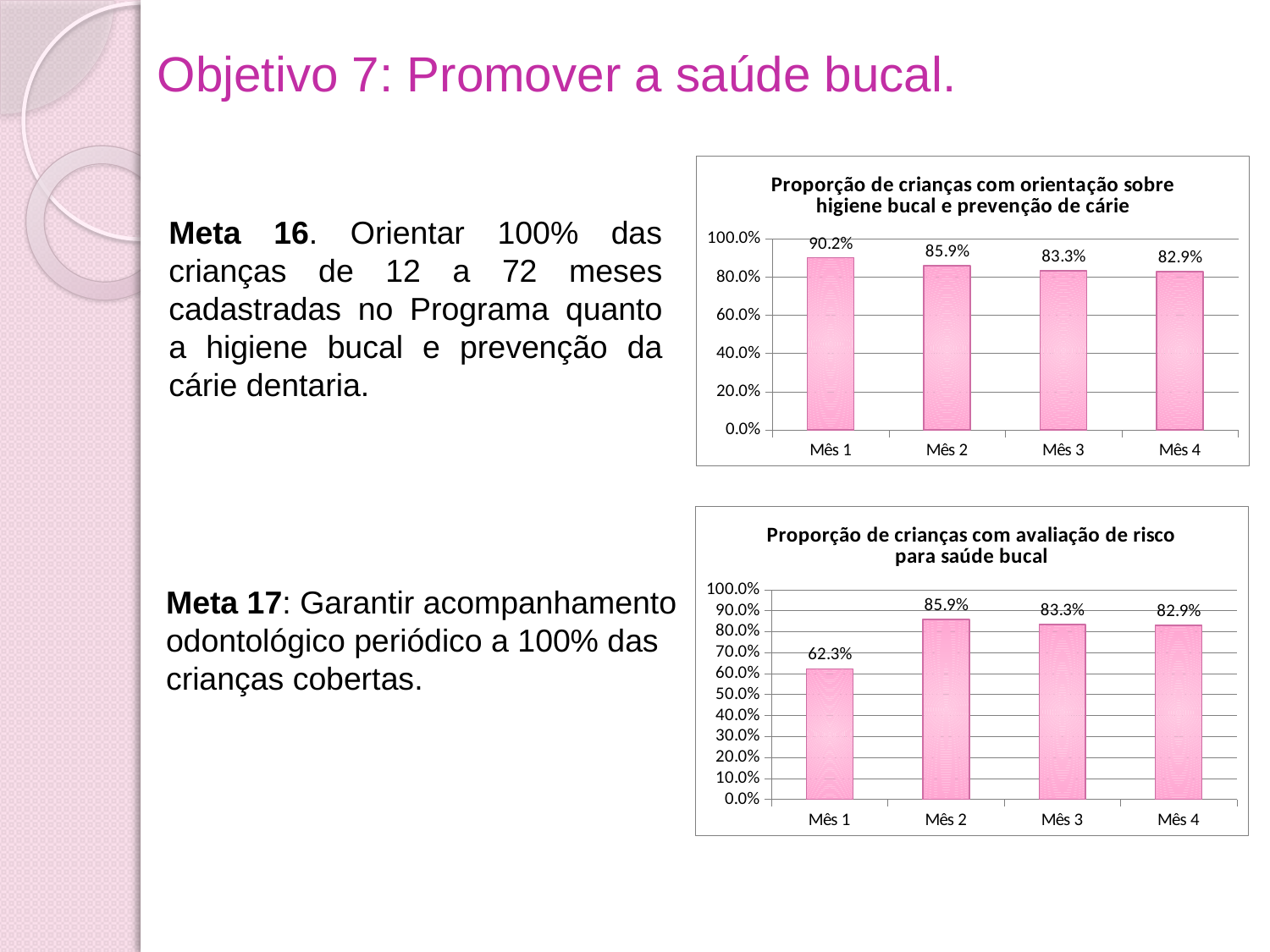
In the bottom chart 'Proporção de crianças com avaliação de risco para saúde bucal', is the value for Mês 1 greater or less than 70.0%? less In the top chart 'Proporção de crianças com orientação sobre higiene bucal e prevenção de cárie', do the values rise or fall from Mês 1 to Mês 4? fall In the top chart 'Proporção de crianças com orientação sobre higiene bucal e prevenção de cárie', what is the value for Mês 3? 83.3% In the bottom chart 'Proporção de crianças com avaliação de risco para saúde bucal', which month has the highest value? Mês 2 In the top chart 'Proporção de crianças com orientação sobre higiene bucal e prevenção de cárie', what is the value for Mês 1? 90.2% In the top chart 'Proporção de crianças com orientação sobre higiene bucal e prevenção de cárie', which month has the lowest value? Mês 4 In the bottom chart 'Proporção de crianças com avaliação de risco para saúde bucal', which is larger, the value for Mês 1 or Mês 3? Mês 3 In the top chart 'Proporção de crianças com orientação sobre higiene bucal e prevenção de cárie', what is the difference between Mês 1 and Mês 4? 7.3% In the bottom chart 'Proporção de crianças com avaliação de risco para saúde bucal', what is the difference between Mês 2 and Mês 1? 23.6% In the bottom chart 'Proporção de crianças com avaliação de risco para saúde bucal', what is the value for Mês 1? 62.3% What kind of chart is the bottom chart 'Proporção de crianças com avaliação de risco para saúde bucal'? bar chart In the top chart 'Proporção de crianças com orientação sobre higiene bucal e prevenção de cárie', how many months are plotted? 4